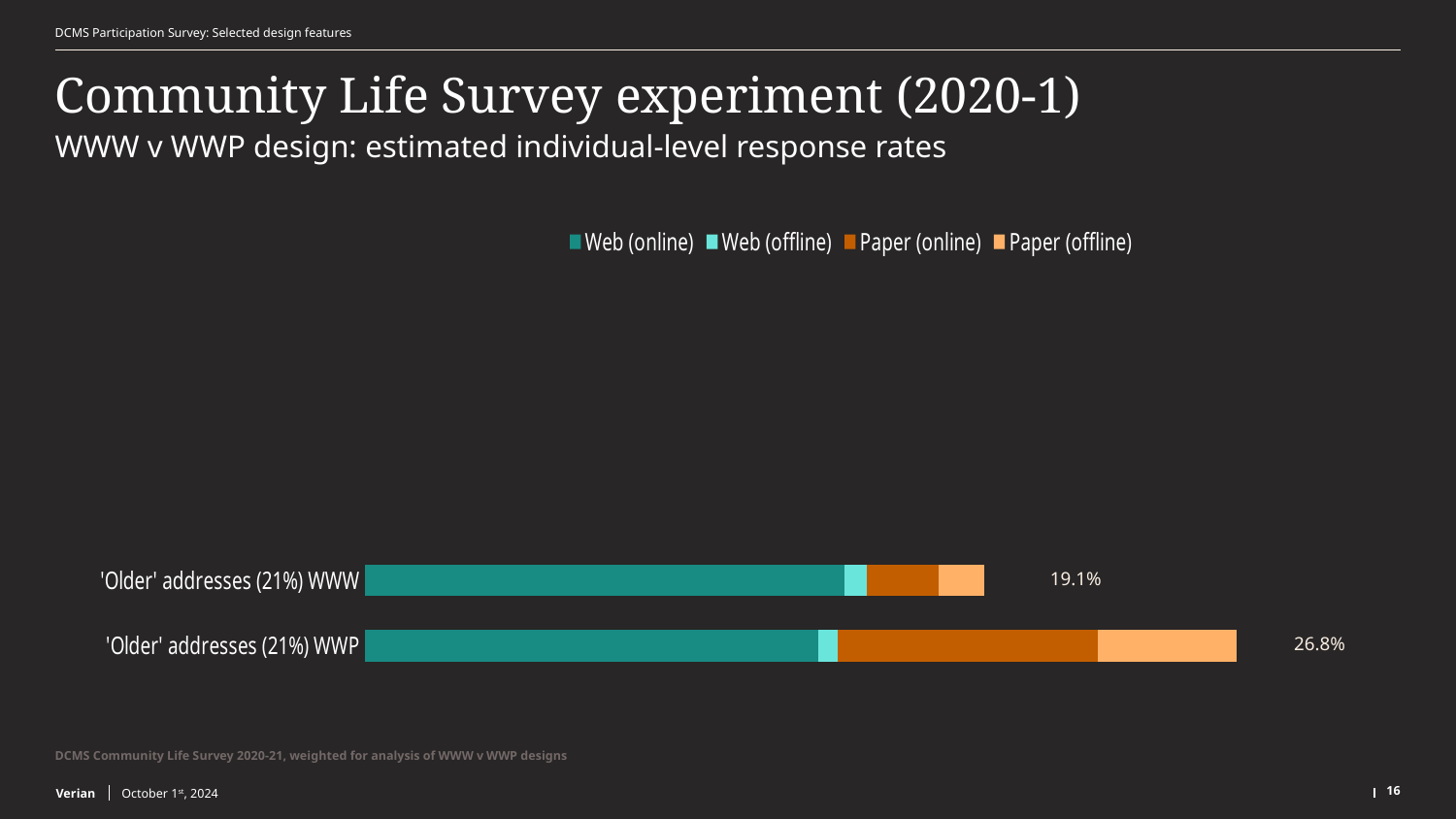
What kind of chart is shown on the slide? Stacked bar chart Which series is shown in the light orange colour in the legend? Paper (offline) Which series is the largest segment in both bars? Web (online) How many bars (categories) are plotted in the chart? 2 Which design has the higher total response rate, WWW or WWP? WWP Is the total response rate for 'Older' addresses (21%) WWP larger than that for 'Older' addresses (21%) WWW? Yes What is the total response rate shown for 'Older' addresses (21%) WWW? 19.1% What are the four series named in the legend? Web (online), Web (offline), Paper (online), Paper (offline) How many series does the legend list? 4 Which design has the lower total response rate, WWW or WWP? WWW What is the total response rate shown for 'Older' addresses (21%) WWP? 26.8% What is the difference in percentage points between the WWP and WWW total response rates? 7.7